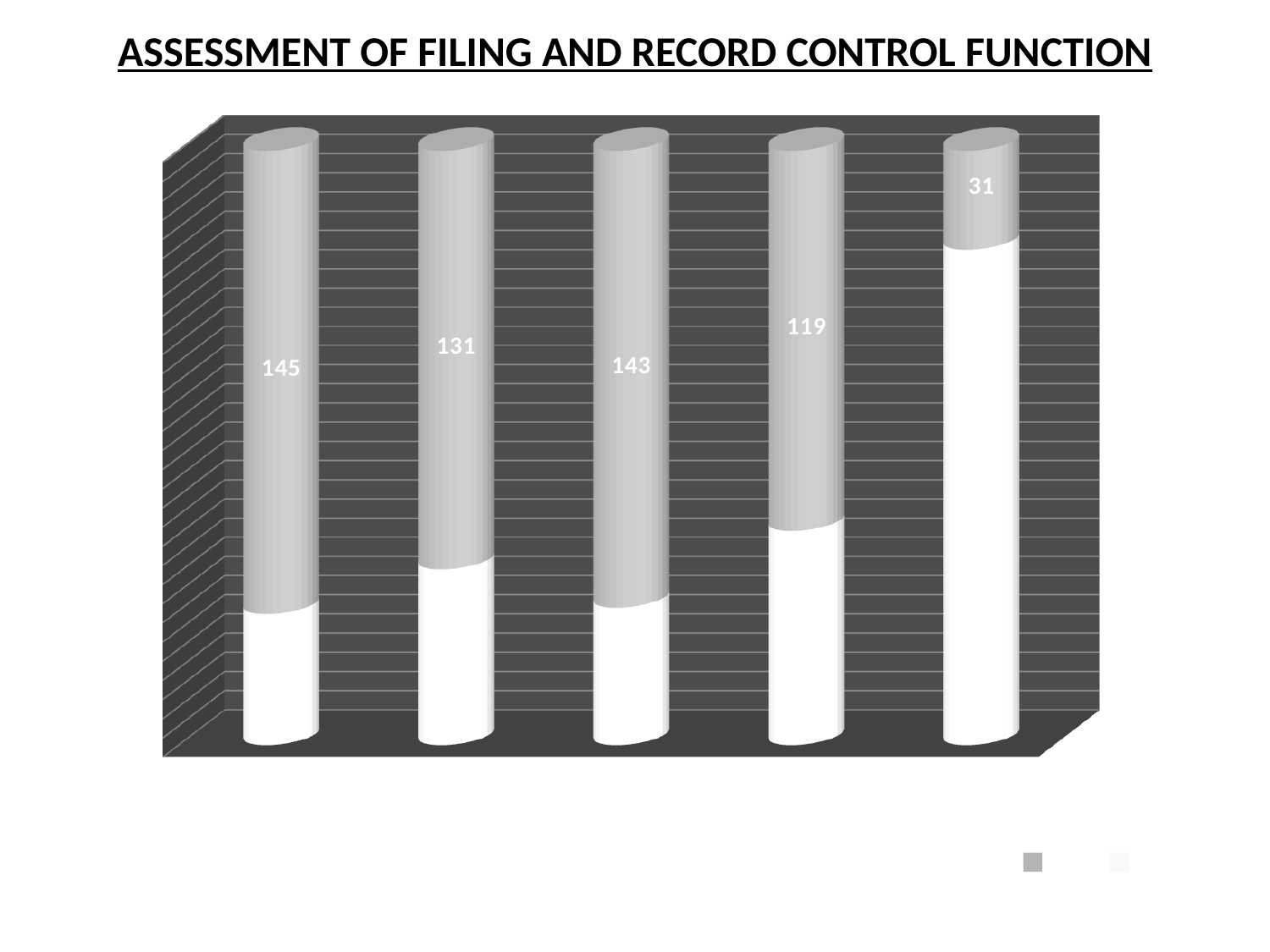
Which bar has the highest labelled grey-segment value? the first bar from the left (145) What is the labelled value of the grey segment of the second bar from the left? 131 What kind of chart is shown on the slide? bar chart What is the title of the chart on the slide? ASSESSMENT OF FILING AND RECORD CONTROL FUNCTION What is the difference between the grey-segment values of the first bar (145) and the rightmost bar (31)? 114 How many series does the legend list? 2 What is the labelled value of the grey segment of the first bar from the left? 145 How many bars are plotted in the chart? 5 Which has the larger grey-segment value, the second bar from the left or the fourth bar from the left? the second bar (131) What is the labelled value of the grey segment of the rightmost bar? 31 Which bar has the lowest labelled grey-segment value? the rightmost bar (31) What is the labelled value of the grey segment of the fourth bar from the left? 119